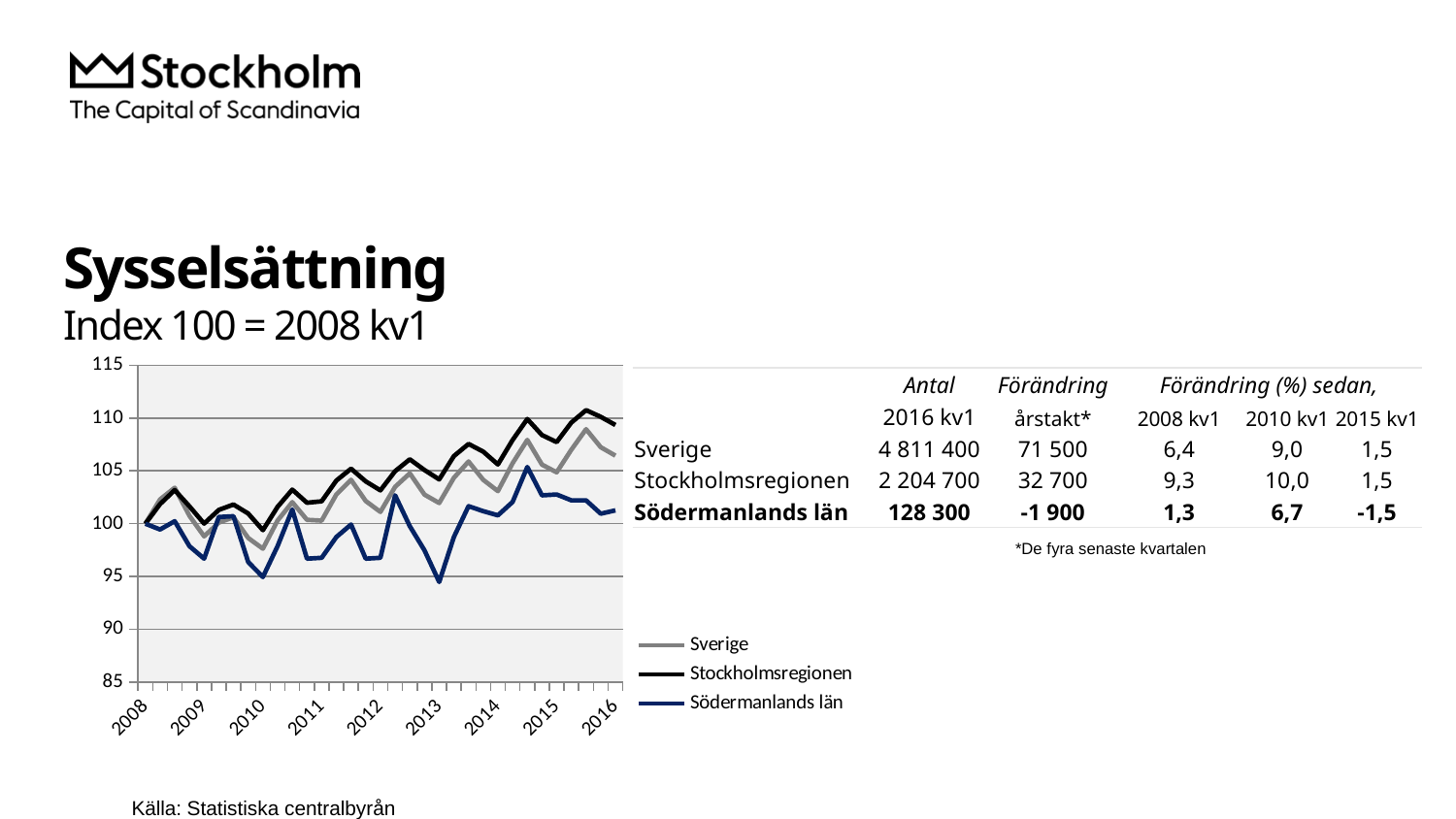
Which series has the highest index value at the end of the chart in 2016? Stockholmsregionen Is the value for Södermanlands län in 2016 greater or less than 105? less What is the title of the chart? Sysselsättning How many series does the chart legend list? 3 Is the value for Sverige in 2016 greater or less than 100? greater At 2016, which series is higher: Stockholmsregionen or Södermanlands län? Stockholmsregionen Is the value for Stockholmsregionen in 2016 greater or less than 105? greater Which series has the lowest index value at the end of the chart in 2016? Södermanlands län What type of chart is shown on the slide? line chart What colour is the line for Södermanlands län in the chart? dark blue How many year labels are shown on the x axis of the chart? 9 Does the Stockholmsregionen line rise or fall overall from 2008 to 2016? rise